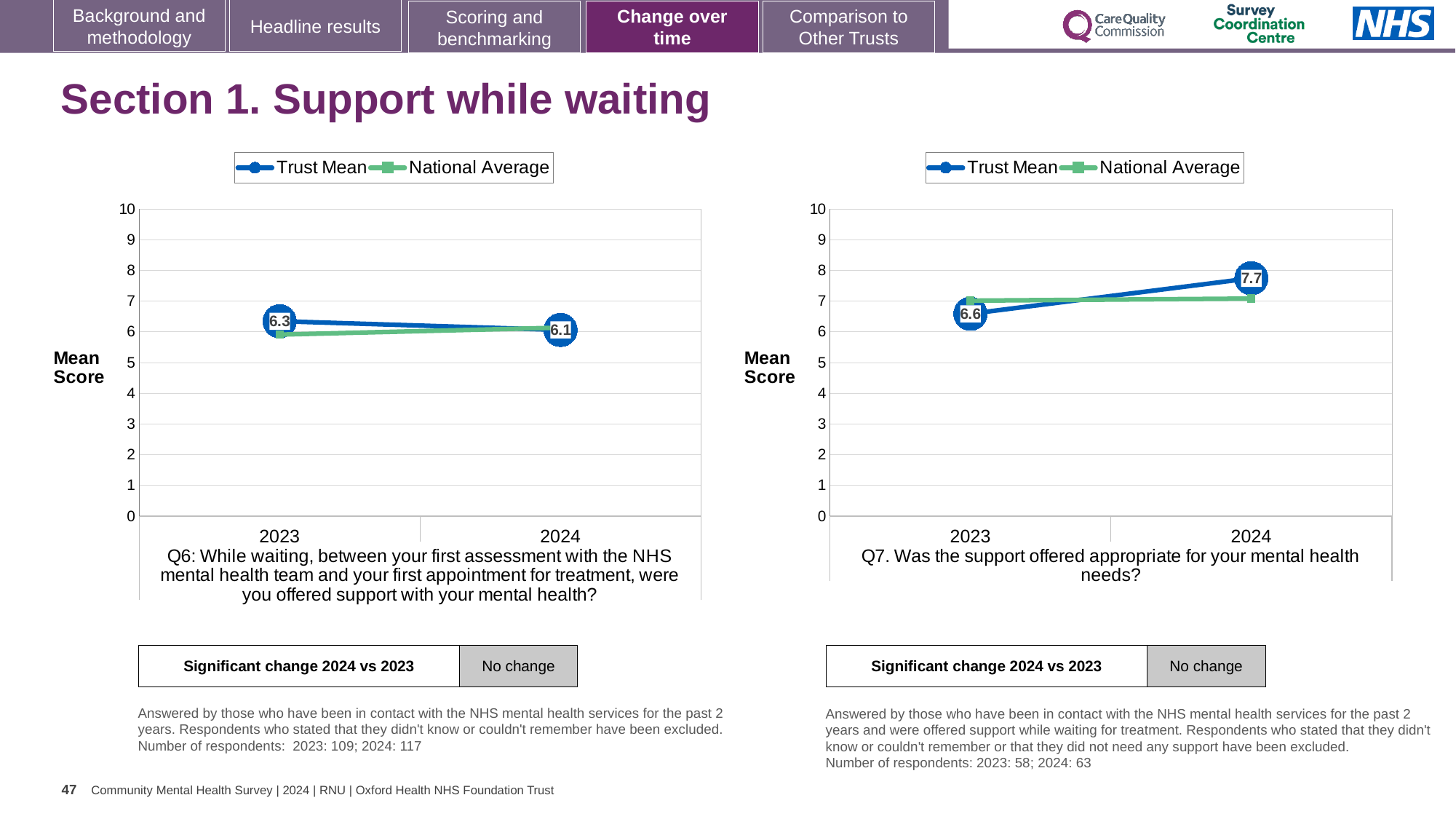
In the Q6 chart on the left, which is higher in 2023, the Trust Mean or the National Average? Trust Mean In the Q7 chart on the right, what is the Trust Mean for 2024? 7.7 In the Q7 chart on the right, by how much did the Trust Mean change from 2023 to 2024? 1.1 In the Q6 chart on the left, what is the Trust Mean for 2023? 6.3 In the Q7 chart on the right, does the Trust Mean rise or fall from 2023 to 2024? rise In the Q7 chart on the right, what is the Trust Mean for 2023? 6.6 In the Q6 chart on the left, does the Trust Mean rise or fall from 2023 to 2024? fall In the Q6 chart on the left, what is the Trust Mean for 2024? 6.1 How many series does the legend of the Q6 chart on the left list? 2 In the Q7 chart on the right, is the National Average for 2024 greater or less than 8? less In the Q6 chart on the left, what is the difference between the Trust Mean in 2023 and in 2024? 0.2 In the Q7 chart on the right, which is higher in 2023, the Trust Mean or the National Average? National Average